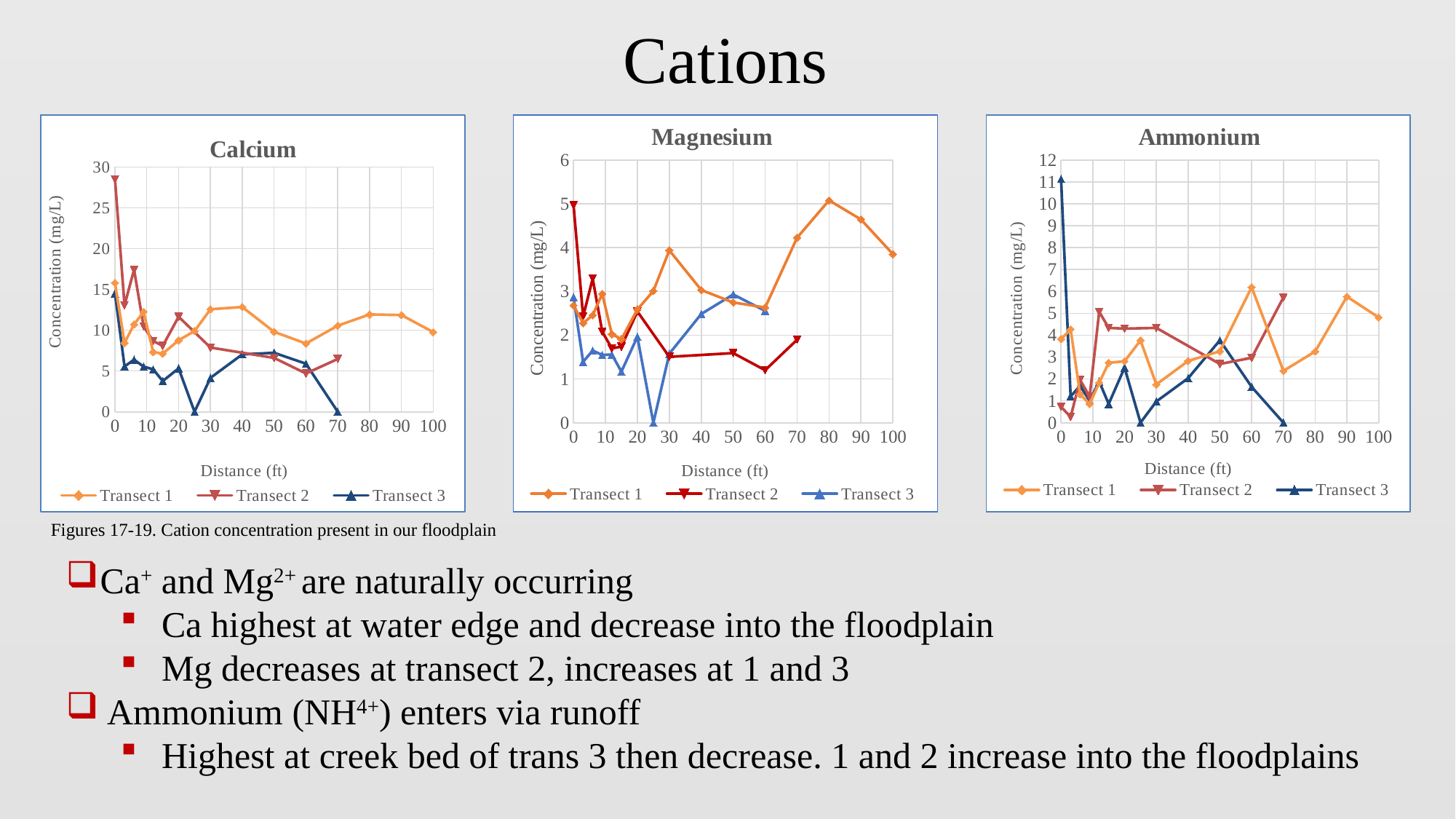
In the Magnesium chart, is the value for Transect 1 at 30 ft greater or less than 3? greater In the Magnesium chart, is the value for Transect 3 at 25 ft greater or less than 1? less In the Calcium chart, which transect has the highest concentration at distance 0 ft? Transect 2 What kind of chart is the Calcium chart? Line chart In the Calcium chart, which series extends to a distance of 100 ft? Transect 1 What is the y-axis label of the Ammonium chart? Concentration (mg/L) In the Ammonium chart, which transect has the highest concentration at distance 0 ft? Transect 3 In the Ammonium chart, is the value for Transect 3 at distance 0 ft greater or less than 10? greater How many series does the legend of the Magnesium chart list? 3 In the Magnesium chart, which is larger: Transect 1 at 80 ft or Transect 2 at 60 ft? Transect 1 at 80 ft